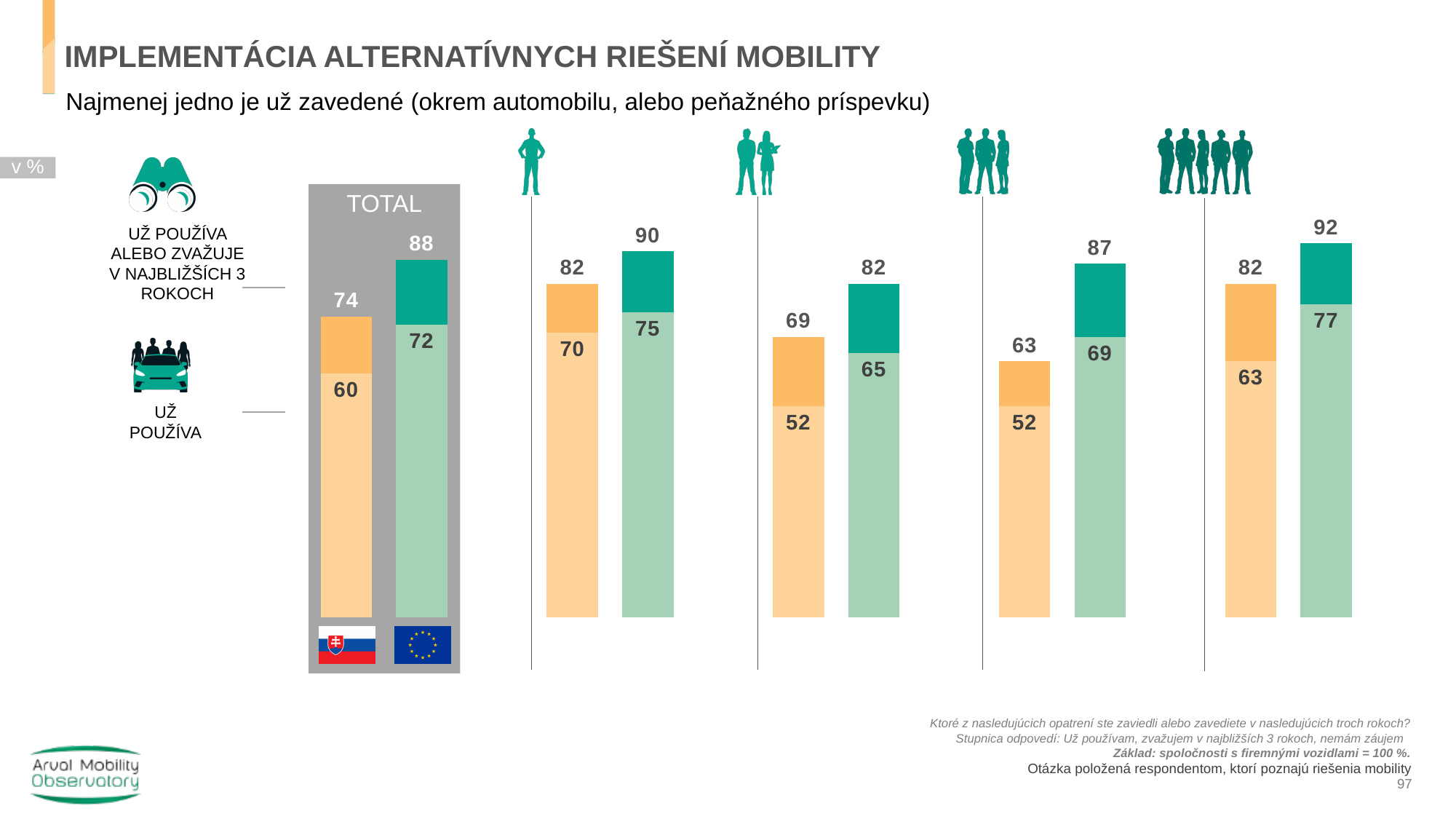
Among the four company-size groups to the right of TOTAL, which group has the highest EU value for 'Už používa alebo zvažuje v najbližších 3 rokoch'? The fourth (largest) group, with 92 In the TOTAL section, what is the 'Už používa' value for Slovakia? 60 In the first company-size group (single-person icon), is the Slovakia value for 'Už používa alebo zvažuje' (82) larger or smaller than the EU value (90)? Smaller In the third company-size group (three-person icon), what is the EU 'Už používa' value? 69 In the TOTAL section, what is the difference between the EU and Slovakia values for 'Už používa alebo zvažuje v najbližších 3 rokoch'? 14 Among the four company-size groups to the right of TOTAL, which group has the lowest Slovakia value for 'Už používa alebo zvažuje v najbližších 3 rokoch'? The third group, with 63 In the fourth company-size group, what is the difference between the EU and Slovakia 'Už používa' values? 14 In the TOTAL section, what is the 'Už používa' value for the EU bar? 72 What type of chart is shown on the slide? Bar chart What unit are the values on the chart expressed in? % In the second company-size group (two-person icon), what is the Slovakia 'Už používa' value? 52 In the TOTAL section, what is the value for Slovakia for 'Už používa alebo zvažuje v najbližších 3 rokoch'? 74